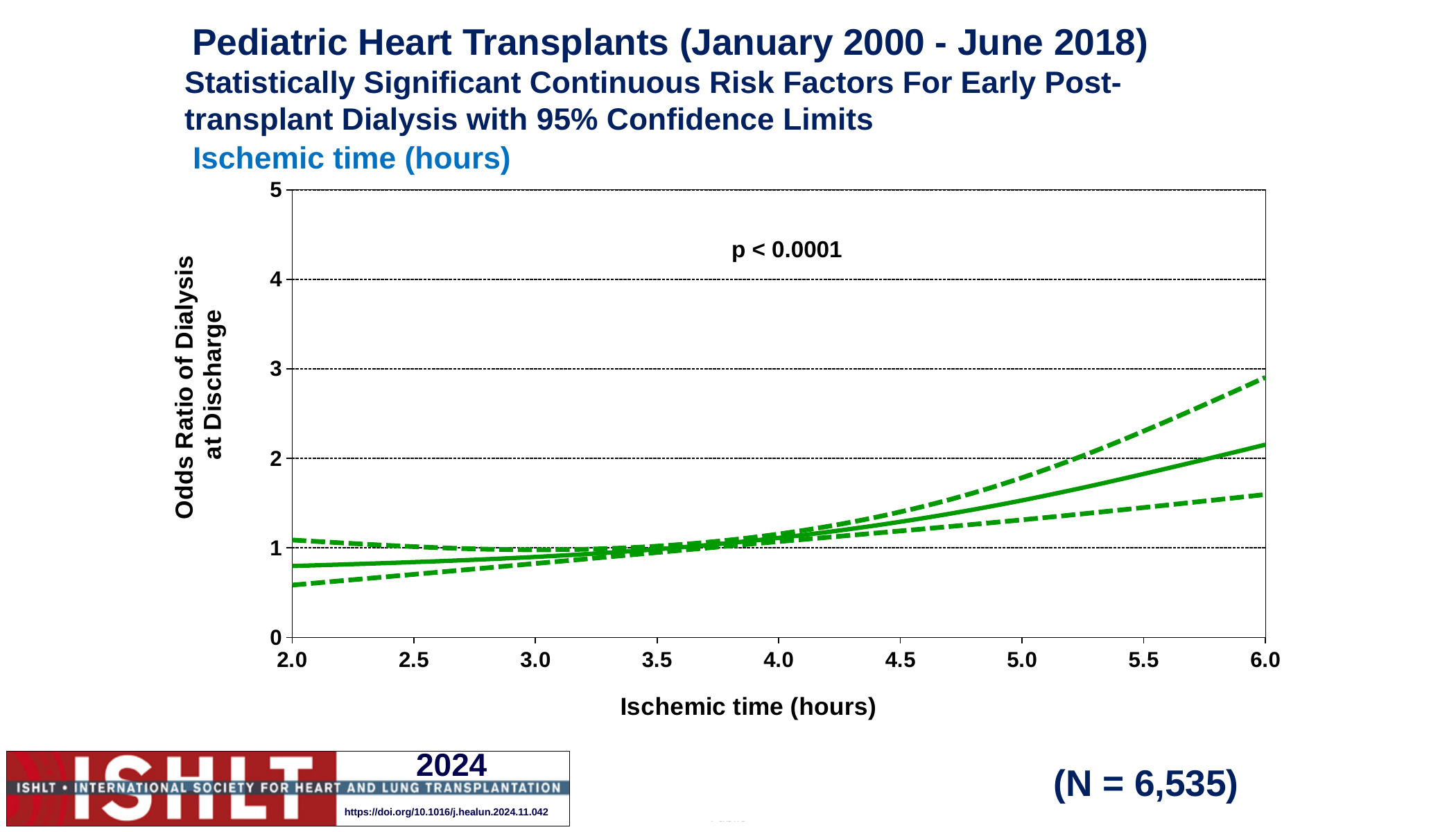
What is the label of the x axis? Ischemic time (hours) What kind of chart is shown on the slide? line chart Is the lower 95% confidence limit (lower dashed line) at 6.0 hours greater or less than 1? greater How many tick labels are shown on the x axis? 9 Does the odds ratio of dialysis at discharge rise or fall as ischemic time increases from 2.0 to 6.0 hours? rise Is the odds ratio (solid line) at an ischemic time of 6.0 hours greater or less than 2? greater Is the odds ratio (solid line) larger at an ischemic time of 6.0 hours or at 2.0 hours? 6.0 hours Is the upper 95% confidence limit (upper dashed line) at 6.0 hours greater or less than 3? less What p-value is printed on the chart? p < 0.0001